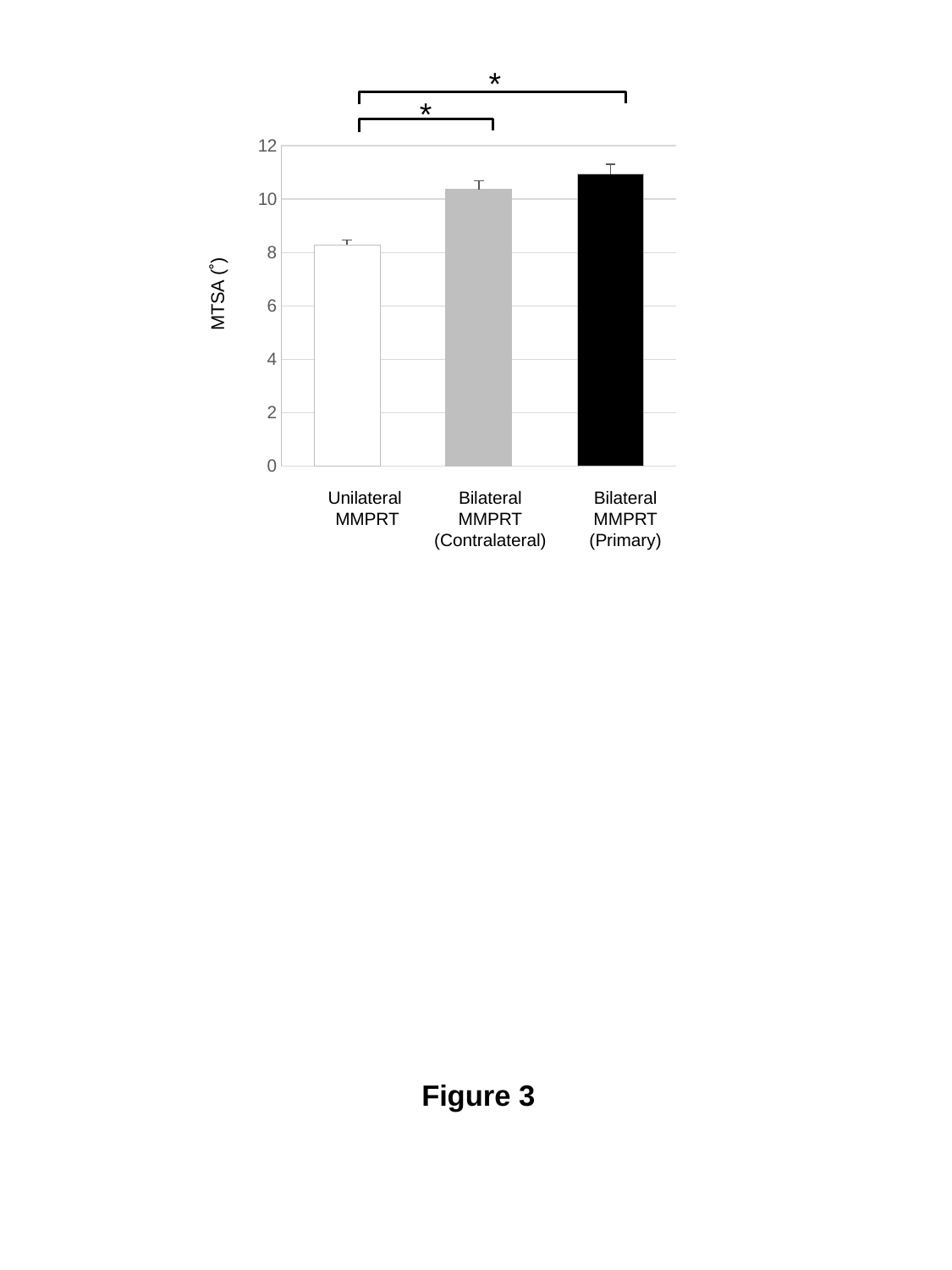
What colour is the bar for Bilateral MMPRT (Primary)? black What is the label on the y axis of the chart? MTSA (°) Is the value for Bilateral MMPRT (Primary) greater or less than 12? less Which category has the highest MTSA value? Bilateral MMPRT (Primary) Which category has the lowest MTSA value? Unilateral MMPRT Which is larger, the value for Unilateral MMPRT or the value for Bilateral MMPRT (Primary)? Bilateral MMPRT (Primary) Is the value for Unilateral MMPRT greater or less than 10? less How many categories are plotted on the x axis? 3 What kind of chart is shown on the slide? bar chart Is the value for Bilateral MMPRT (Contralateral) greater or less than 10? greater Which is larger, the value for Unilateral MMPRT or the value for Bilateral MMPRT (Contralateral)? Bilateral MMPRT (Contralateral)